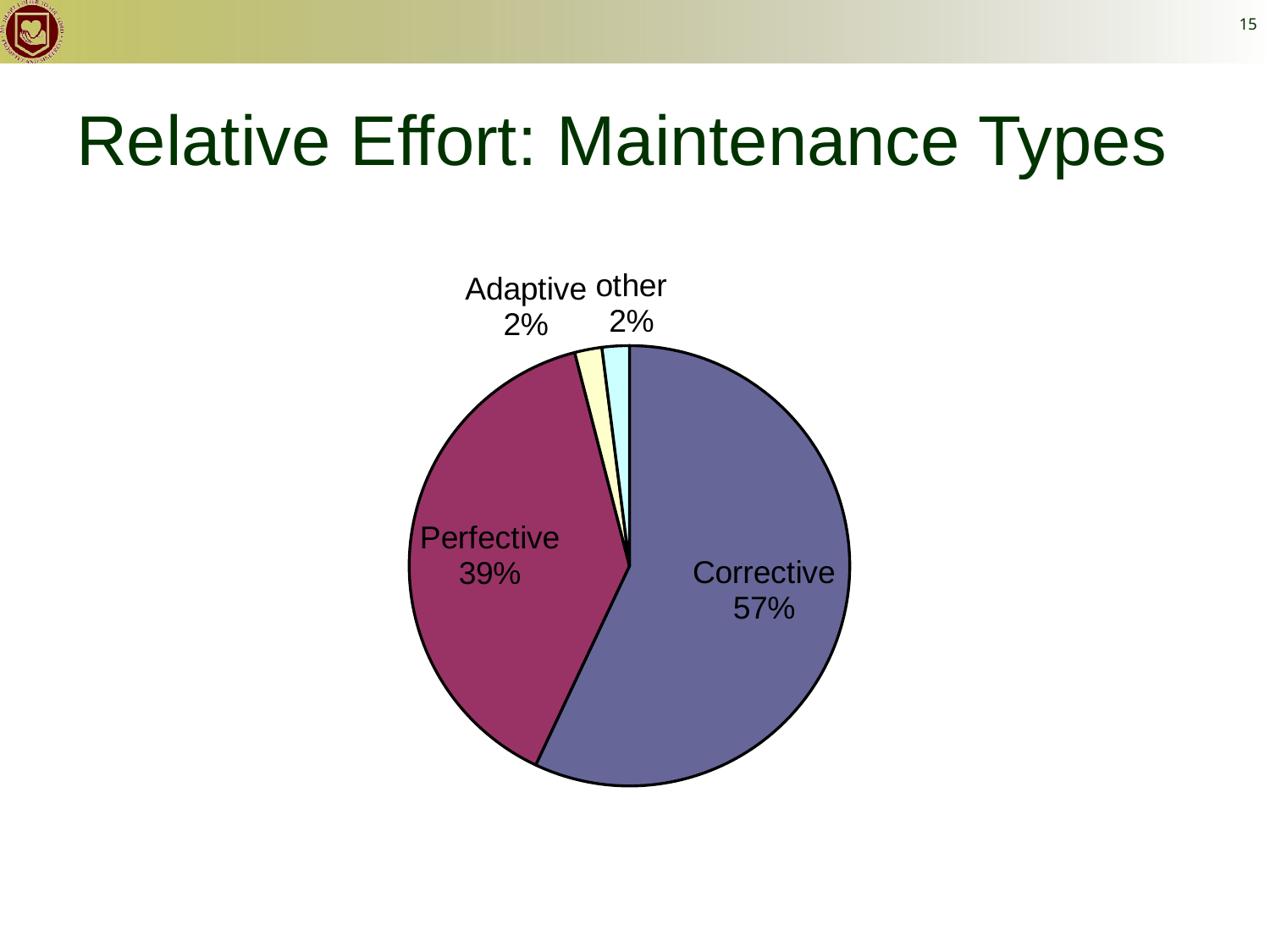
What kind of chart is shown on the slide? Pie chart What colour is the Perfective slice? Magenta/purple-red What percentage is shown for the 'other' slice? 2% What is the combined share of Corrective and Perfective maintenance? 96% What percentage is shown for Adaptive maintenance? 2% Which maintenance type has the largest share of effort? Corrective Which is larger, the Perfective share or the Corrective share? Corrective What is the difference in percentage points between Corrective and Perfective? 18 How many slices does the pie chart have? 4 What is the title of the slide containing the chart? Relative Effort: Maintenance Types What share of the pie does Perfective maintenance account for? 39% What share of the pie does Corrective maintenance account for? 57%